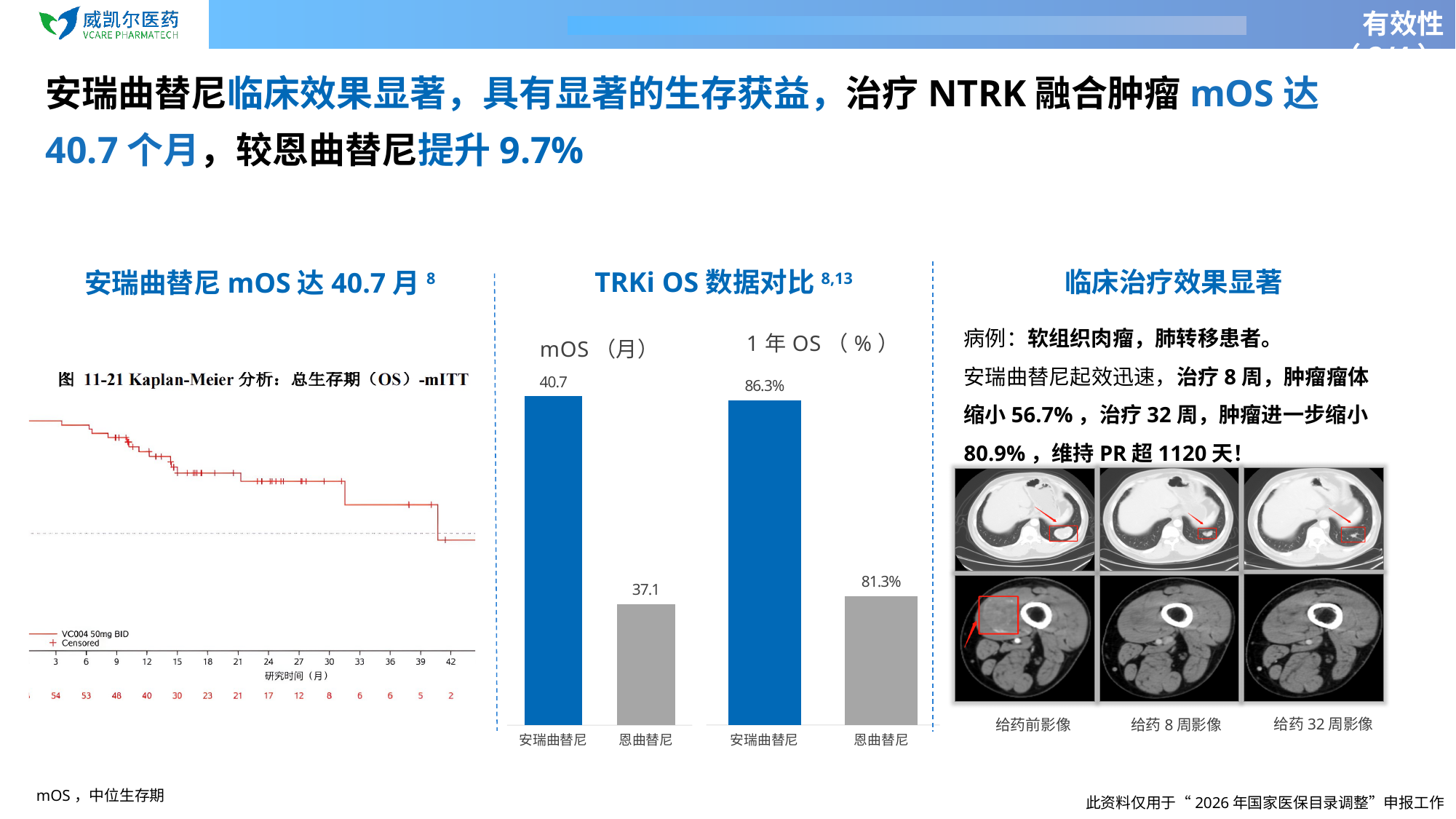
How many categories are shown in the mOS (月) bar chart? 2 What kind of chart is used in the 'TRKi OS 数据对比' section? bar chart In the 1 年 OS (%) bar chart, what is the difference between the values for 安瑞曲替尼 and 恩曲替尼? 5.0% In the 1 年 OS (%) bar chart under 'TRKi OS 数据对比', what is the value for 安瑞曲替尼? 86.3% In the mOS (月) bar chart, what is the difference between the values for 安瑞曲替尼 and 恩曲替尼? 3.6 In the Kaplan-Meier chart on the left, does the survival curve rise or fall as study time increases? fall What is the x-axis label of the Kaplan-Meier chart on the left? 研究时间（月） In the mOS (月) bar chart under 'TRKi OS 数据对比', what is the value for 安瑞曲替尼? 40.7 In the 1 年 OS (%) bar chart under 'TRKi OS 数据对比', what is the value for 恩曲替尼? 81.3% In the mOS (月) bar chart under 'TRKi OS 数据对比', what is the value for 恩曲替尼? 37.1 In the 1 年 OS (%) bar chart, which category has the highest value? 安瑞曲替尼 In the mOS (月) bar chart, which has the larger value, 安瑞曲替尼 or 恩曲替尼? 安瑞曲替尼